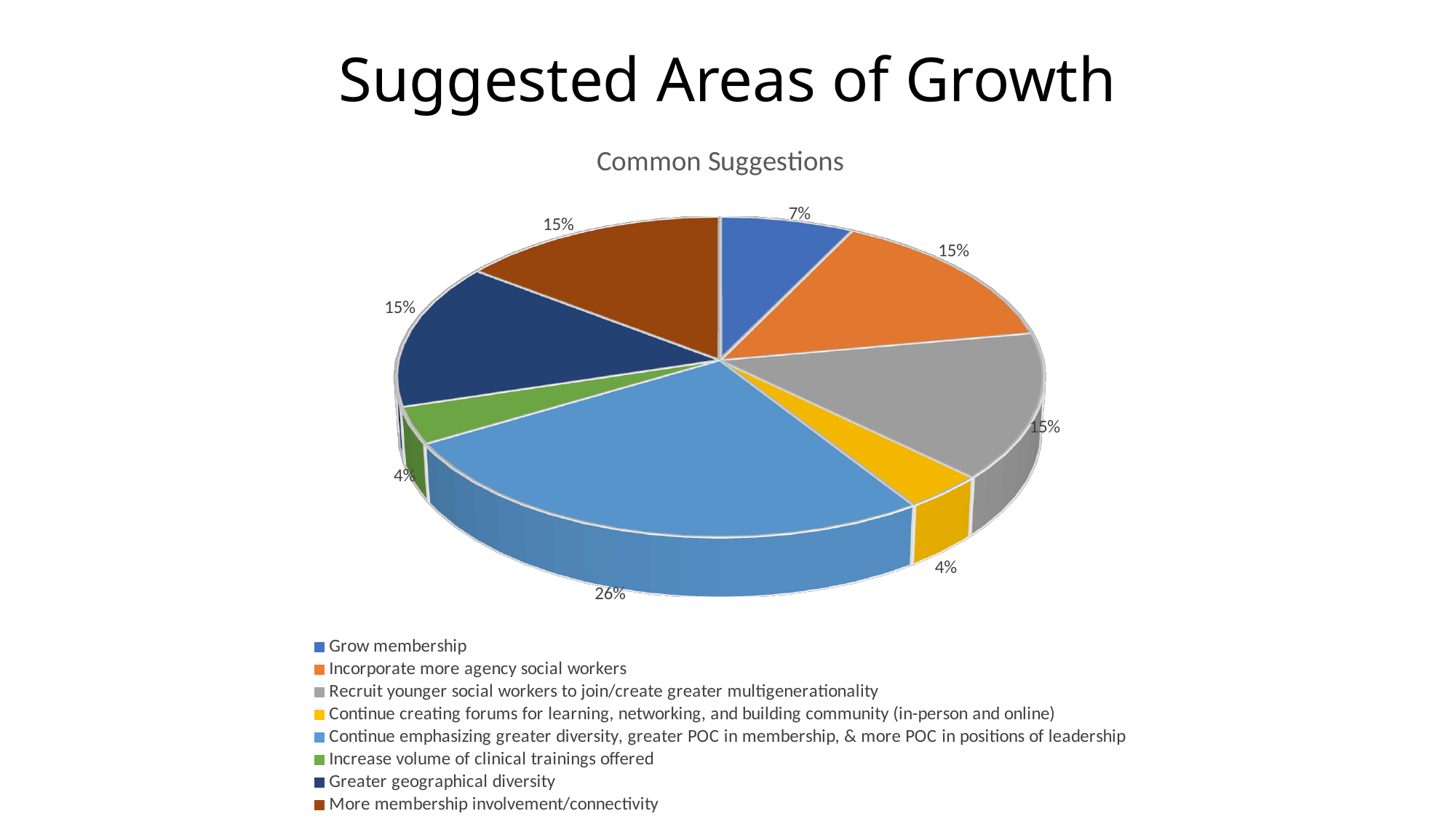
Which category has the largest slice of the pie? Continue emphasizing greater diversity, greater POC in membership, & more POC in positions of leadership How many categories does the pie chart have? 8 What is the difference in percentage points between the "Continue emphasizing greater diversity" slice and the "Grow membership" slice? 19 What kind of chart is shown on the slide? Pie chart What percentage is shown for "Grow membership"? 7% What percentage is shown for "Increase volume of clinical trainings offered"? 4% What colour is the slice for "More membership involvement/connectivity"? Brown What share of the pie does "Continue emphasizing greater diversity, greater POC in membership, & more POC in positions of leadership" represent? 26% What percentage is shown for "Greater geographical diversity"? 15% What is the title of the chart? Common Suggestions Which is larger: the slice for "Grow membership" or the slice for "Incorporate more agency social workers"? Incorporate more agency social workers How many categories share the value 15%? 4